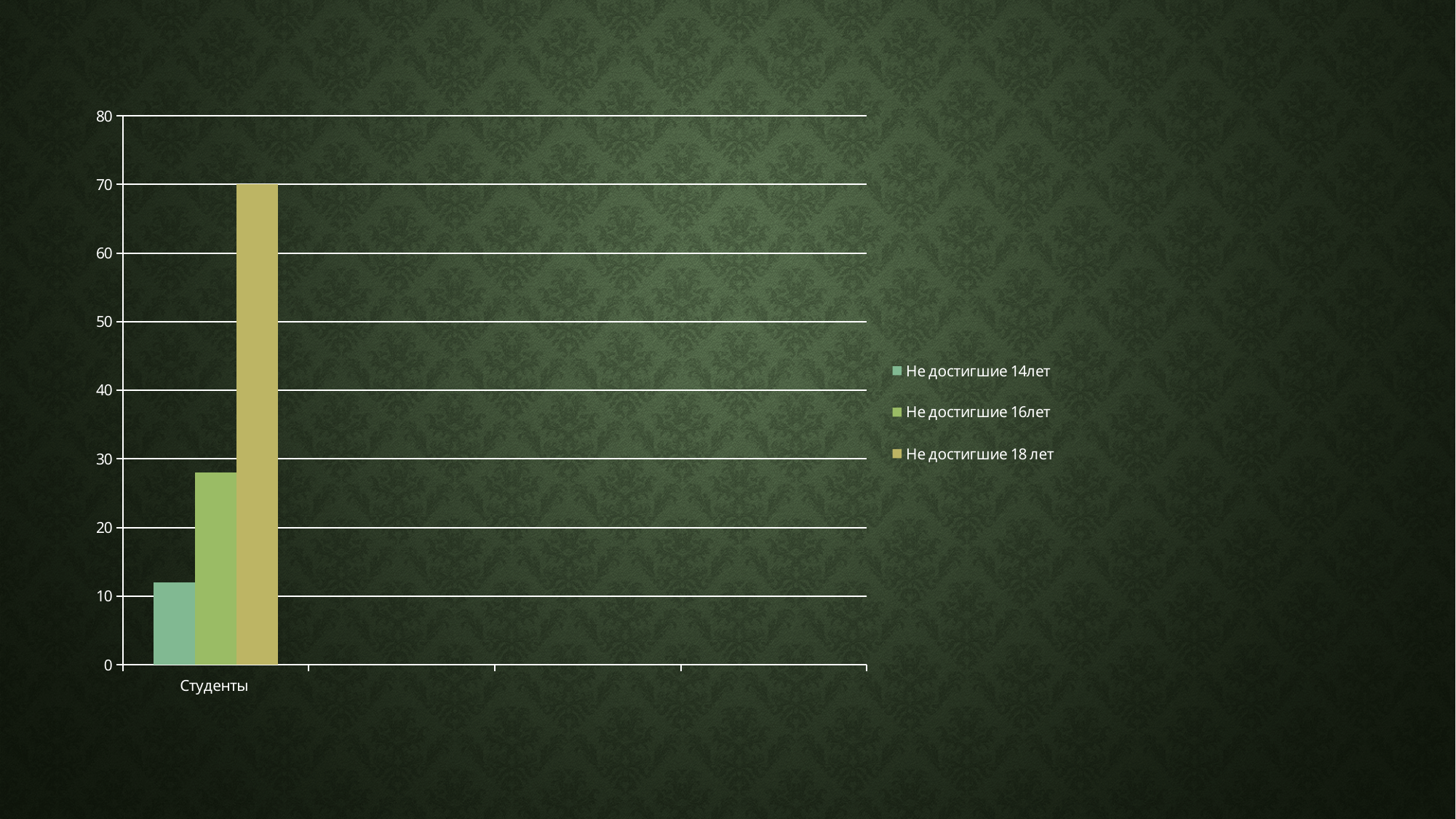
What is the highest value shown on the y axis? 80 Is the value for Не достигшие 14лет greater or less than 20? less How many categories are shown on the x axis? 1 Is the value for Не достигшие 16лет greater or less than 20? greater Which is larger, the bar for Не достигшие 16лет or the bar for Не достигшие 14лет? Не достигшие 16лет What kind of chart is shown on the slide? bar chart What is the label of the category on the x axis? Студенты What is the value of the Не достигшие 18 лет bar for Студенты? 70 How many series does the legend list? 3 Which series has the lowest bar for Студенты? Не достигшие 14лет Which series has the highest bar for Студенты? Не достигшие 18 лет Is the value for Не достигшие 16лет greater or less than 30? less